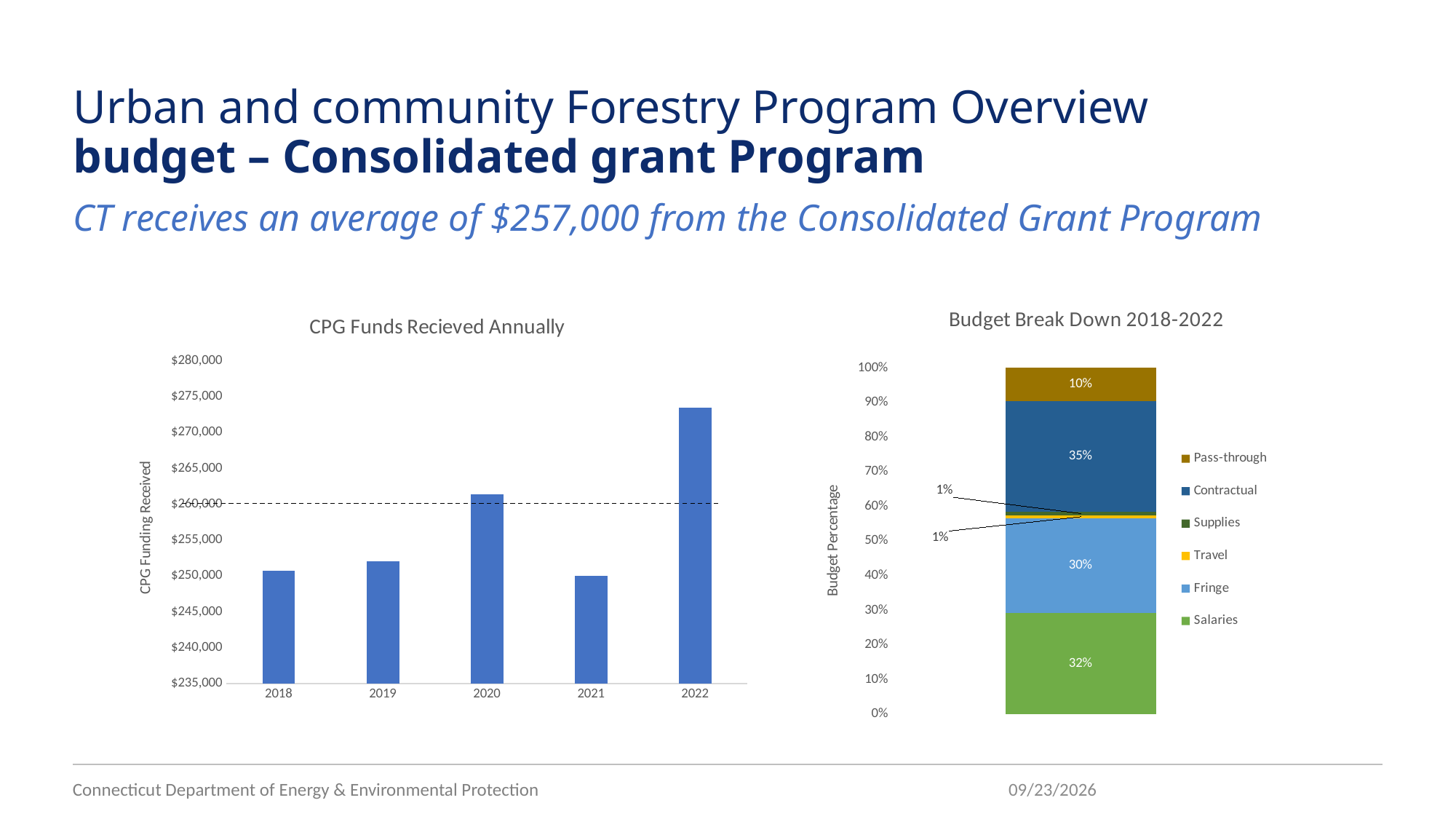
In the Budget Break Down 2018-2022 chart, what percentage of the budget is Salaries? 32% In the Budget Break Down 2018-2022 chart, what percentage of the budget is Pass-through? 10% In the Budget Break Down 2018-2022 chart, what percentage of the budget is Fringe? 30% In the CPG Funds Recieved Annually chart, is the value for 2022 greater or less than $270,000? greater In the Budget Break Down 2018-2022 chart, which budget category has the largest share? Contractual In the CPG Funds Recieved Annually chart, how many years are shown on the x axis? 5 In the Budget Break Down 2018-2022 chart, how many categories does the legend list? 6 In the CPG Funds Recieved Annually chart, which year received more funding, 2020 or 2019? 2020 In the Budget Break Down 2018-2022 chart, what is the difference in percentage points between Contractual and Fringe? 5% In the Budget Break Down 2018-2022 chart, what percentage of the budget is Contractual? 35% In the CPG Funds Recieved Annually chart, which year received the most CPG funding? 2022 In the CPG Funds Recieved Annually chart, is the value for 2019 greater or less than $255,000? less